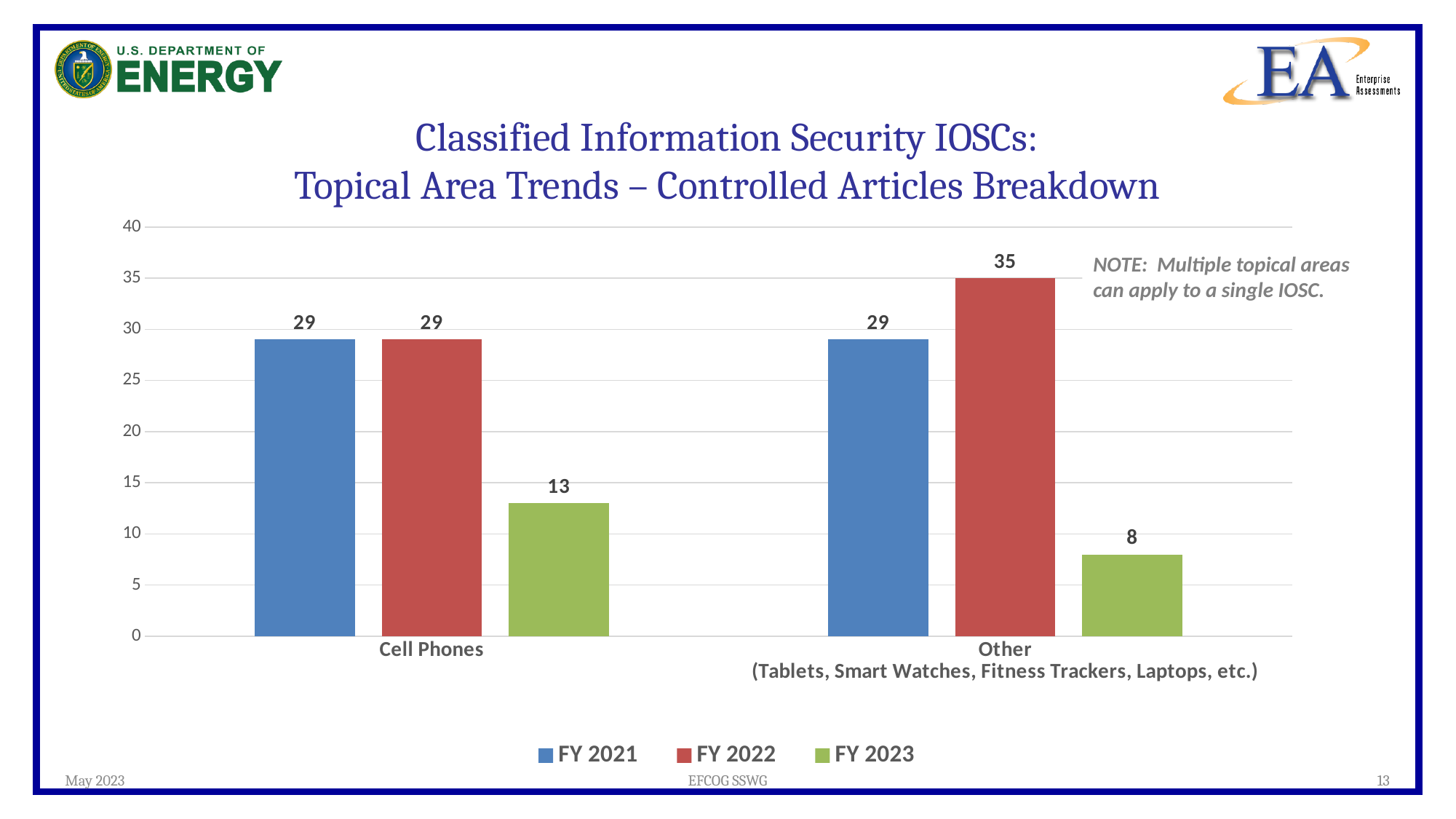
What is the difference between the FY 2022 and FY 2023 values for Other? 27 Which series has the lowest value for Cell Phones? FY 2023 What is the FY 2023 value for Cell Phones? 13 Which series has the highest value for the Other category? FY 2022 What is the FY 2023 value for Other? 8 How many categories are shown on the x axis? 2 Which is larger, the FY 2023 value for Cell Phones or the FY 2023 value for Other? Cell Phones What kind of chart is shown on the slide? Bar chart How many series does the legend list? 3 What is the FY 2021 value for Cell Phones? 29 What is the difference between the FY 2021 and FY 2023 values for Cell Phones? 16 What is the FY 2022 value for Other (Tablets, Smart Watches, Fitness Trackers, Laptops, etc.)? 35